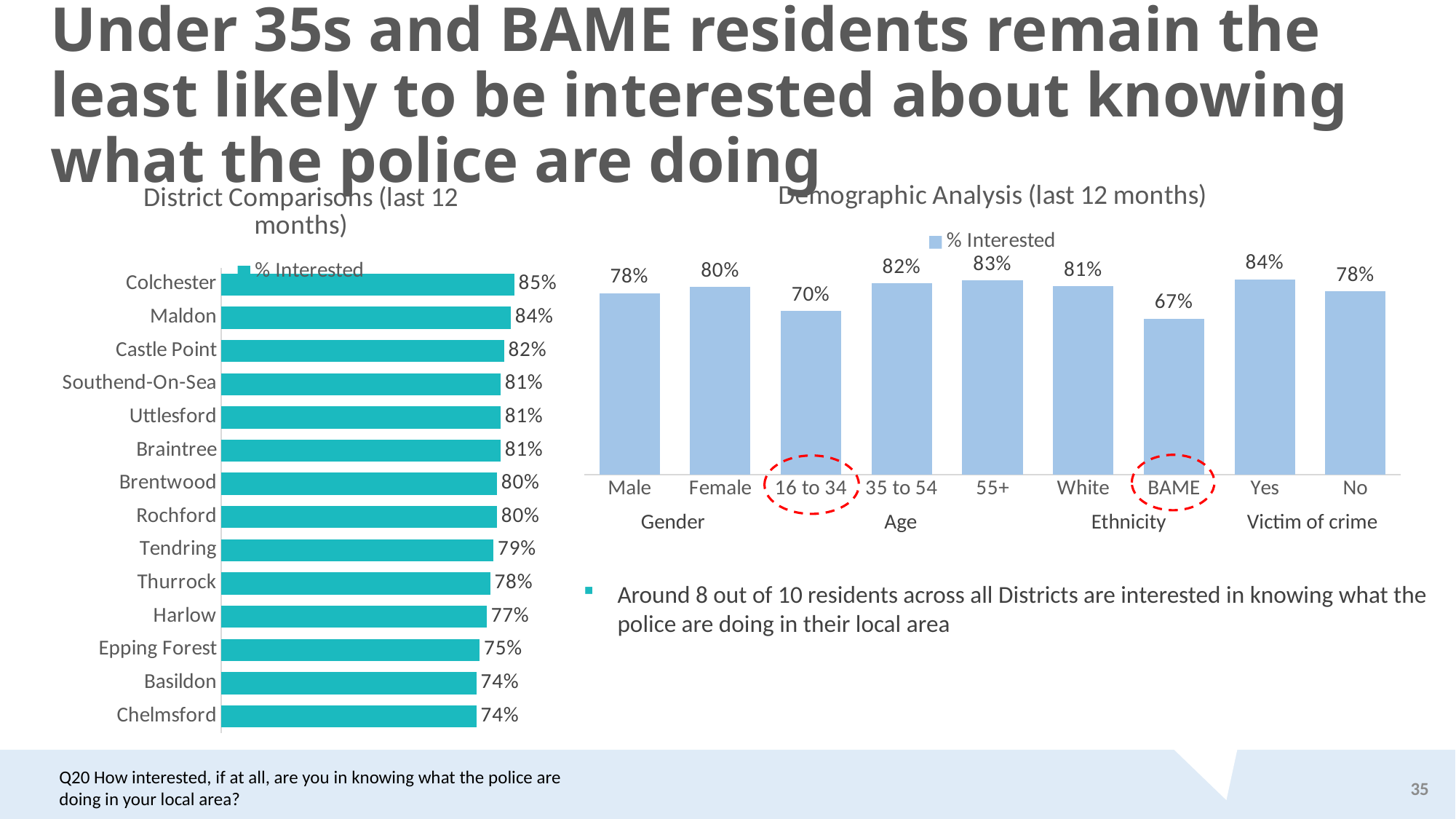
What kind of chart is the Demographic Analysis chart? Bar chart In the Demographic Analysis chart, what is the value for BAME? 67% In the Demographic Analysis chart, which category has the highest % Interested? Yes In the District Comparisons chart, what is the value for Epping Forest? 75% In the District Comparisons chart, which is larger, Maldon or Harlow? Maldon In the Demographic Analysis chart, how many categories are plotted? 9 In the District Comparisons chart, what is the % Interested value for Colchester? 85% In the Demographic Analysis chart, what is the difference between Female and Male? 2% In the District Comparisons chart, which district has the highest % Interested? Colchester In the District Comparisons chart, what is the difference between Colchester and Chelmsford? 11% In the District Comparisons chart, how many districts are shown? 14 In the Demographic Analysis chart, which category has the lowest % Interested? BAME